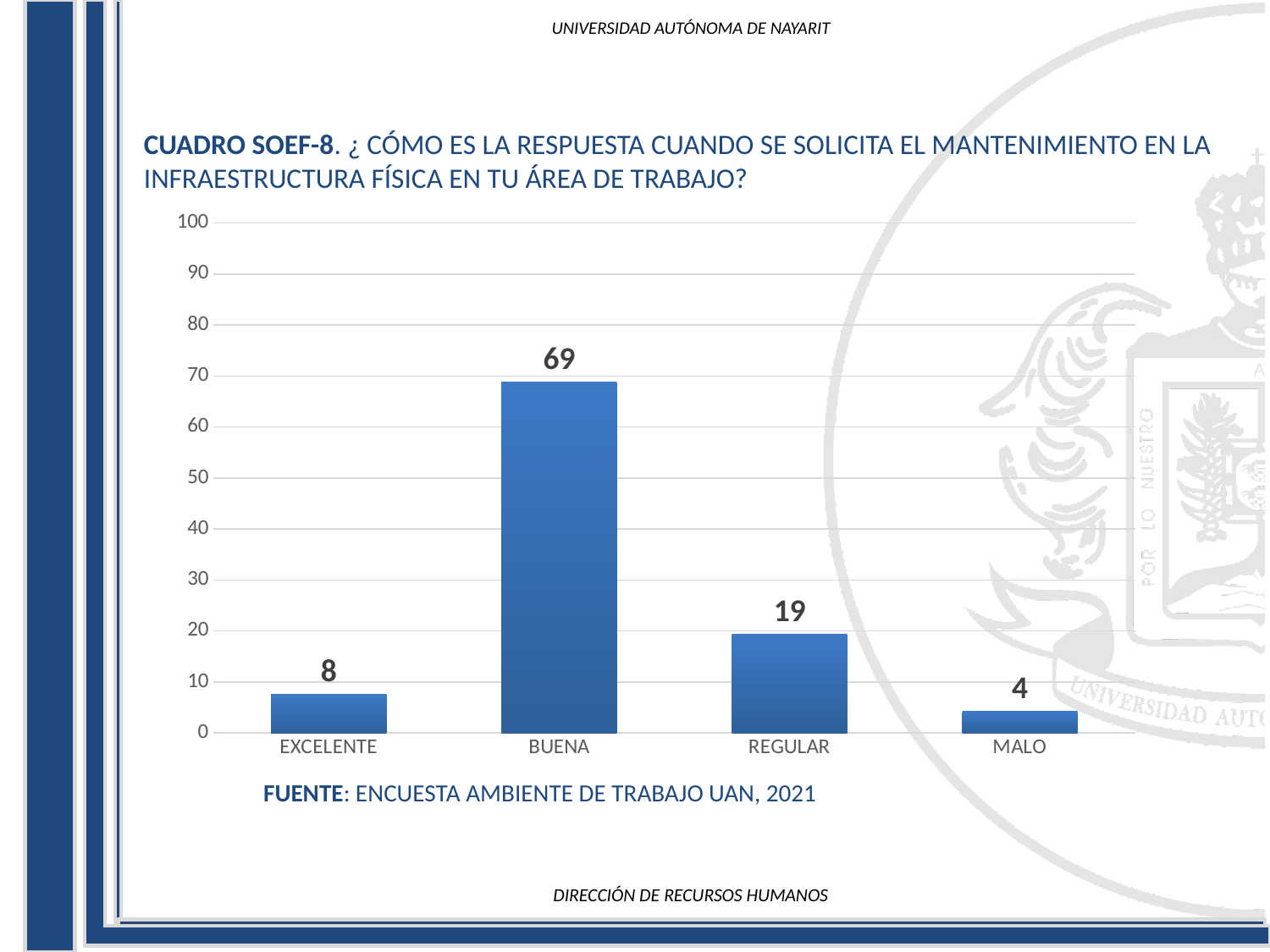
What is the difference between the values for BUENA and REGULAR? 50 What is the value for BUENA? 69 Which is larger, the value for EXCELENTE or the value for MALO? EXCELENTE What is the value for MALO? 4 Which category has the lowest value? MALO What source is cited below the chart? ENCUESTA AMBIENTE DE TRABAJO UAN, 2021 What is the value for REGULAR? 19 How many categories are shown on the x axis? 4 Which category has the highest value? BUENA What kind of chart is shown on the slide? bar chart Is the value for REGULAR greater or less than 30? less What is the value for EXCELENTE? 8